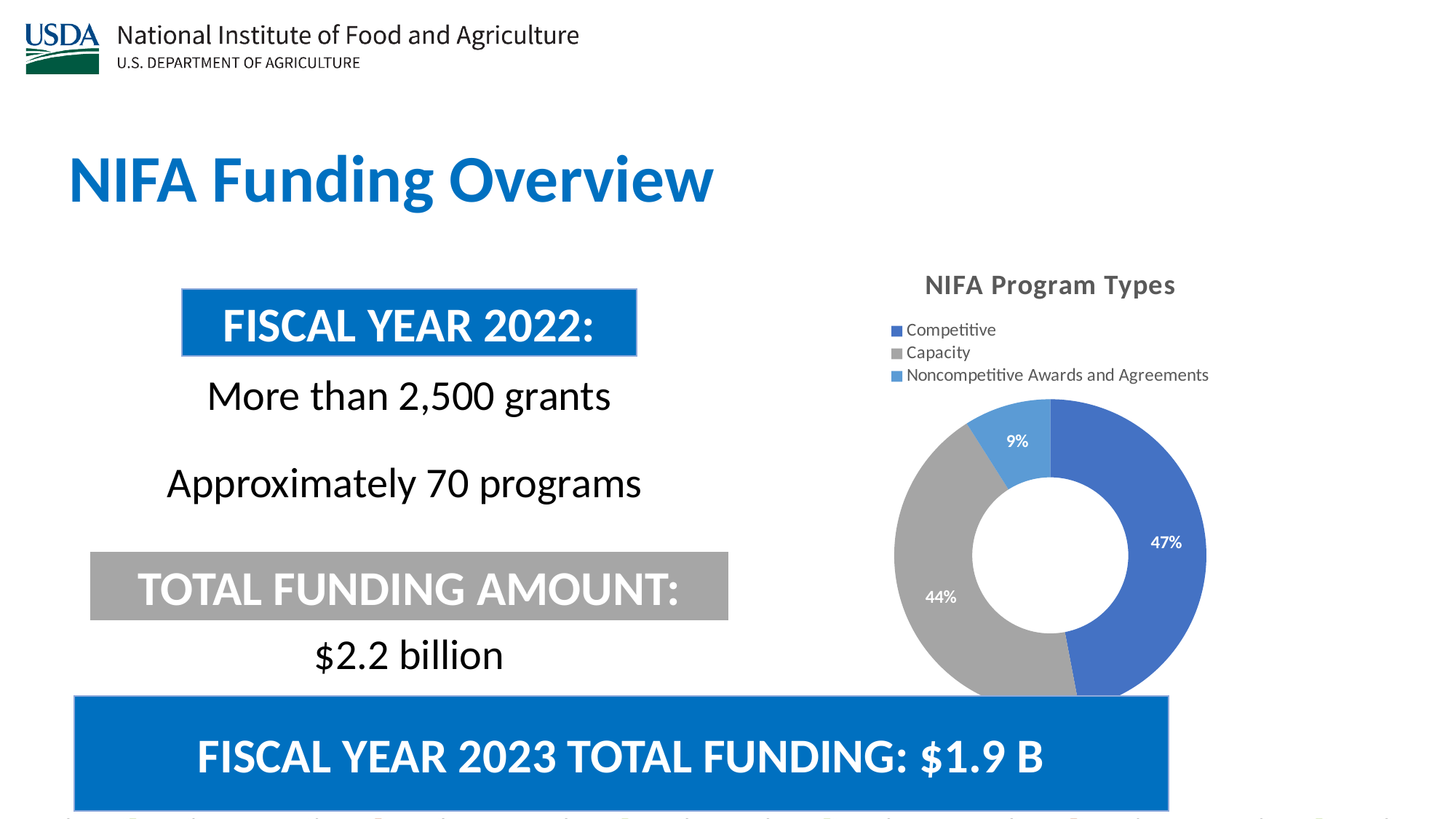
What colour represents Capacity in the NIFA Program Types chart? Gray How many program types are shown in the NIFA Program Types chart? 3 Which program type has the smallest share in the NIFA Program Types chart? Noncompetitive Awards and Agreements What is the difference in percentage points between the Competitive and Capacity shares in the NIFA Program Types chart? 3 percentage points Which program type has the largest share in the NIFA Program Types chart? Competitive What kind of chart is the NIFA Program Types chart? Doughnut (pie) chart What share of the NIFA Program Types chart is Capacity? 44% What share of the NIFA Program Types chart is Noncompetitive Awards and Agreements? 9% What is the difference in percentage points between the Capacity and Noncompetitive Awards and Agreements shares in the NIFA Program Types chart? 35 percentage points What is the title of the chart on the slide? NIFA Program Types What share of the NIFA Program Types chart is Competitive? 47% In the NIFA Program Types chart, which is larger: Capacity or Noncompetitive Awards and Agreements? Capacity